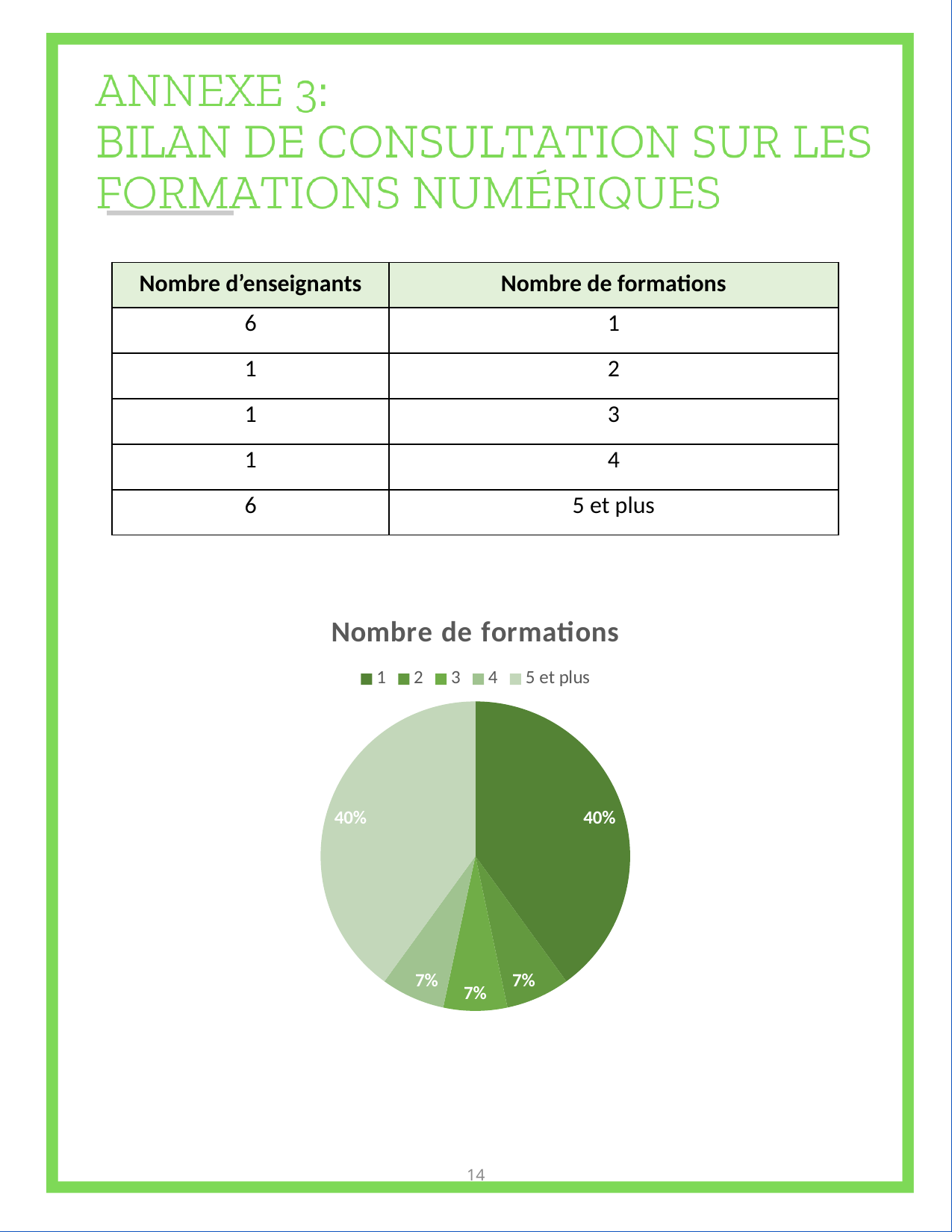
What is the difference in percentage points between the slice for "5 et plus" and the slice for "4"? 33% Which slice is larger, "1" or "2"? 1 What type of chart is shown on the slide? pie chart How many slices does the pie chart have? 5 What is the title of the pie chart? Nombre de formations What share of the pie does the slice for "5 et plus" represent? 40% What share of the pie does the slice for "2" represent? 7% What share of the pie does the slice for "4" represent? 7% How many entries does the legend of the pie chart list? 5 Which legend entry is shown in the darkest green in the pie chart? 1